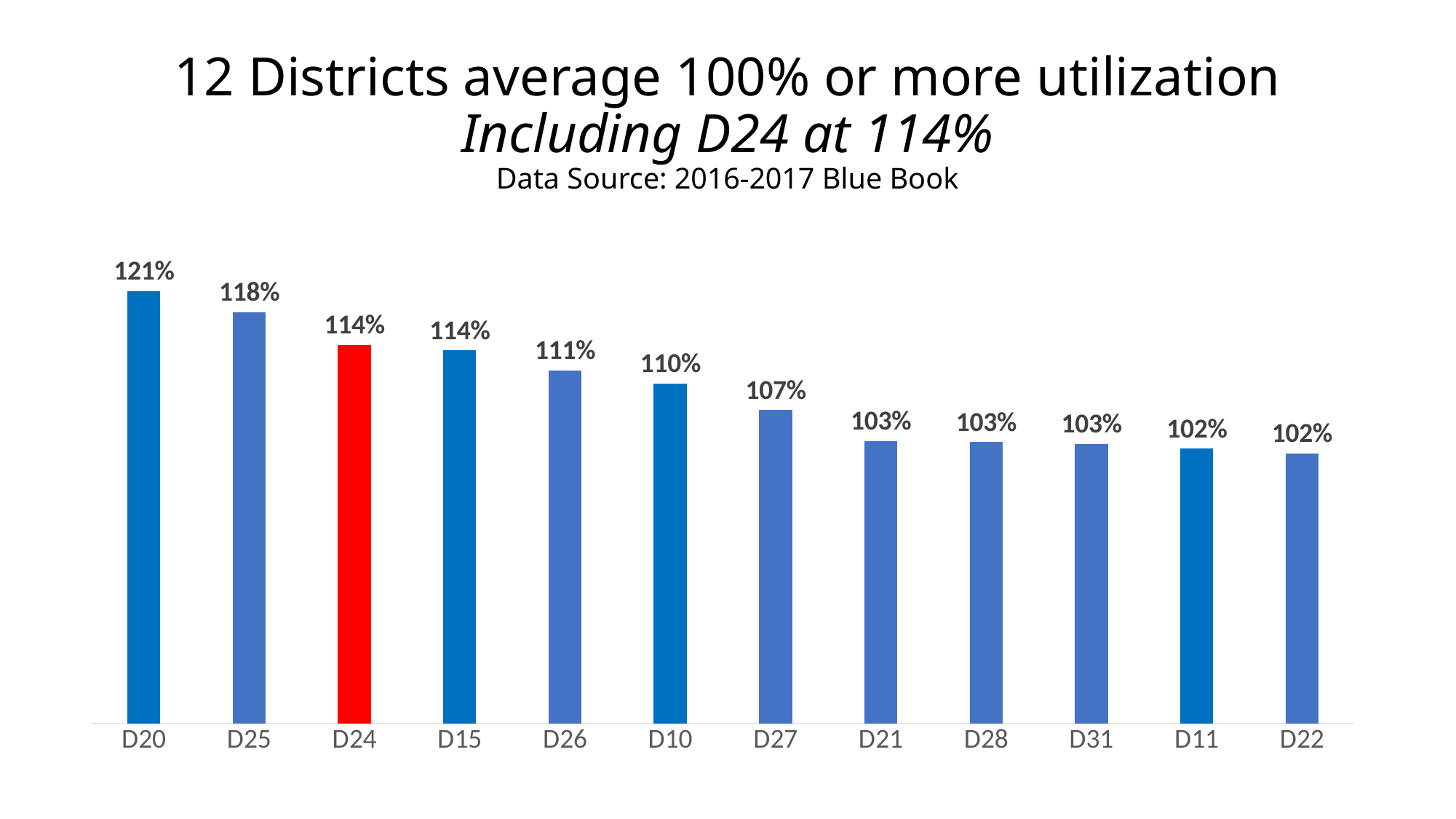
Do the values rise or fall from left to right along the x axis? Fall What is the utilization value for D20? 121% What is the difference between the utilization of D24 and D22? 12% What is the difference between the utilization of D20 and D25? 3% What kind of chart is shown on the slide? Bar chart What is the utilization value for D27? 107% What is the utilization value for D24? 114% What is the utilization value for D10? 110% Which district has the highest utilization? D20 Which has a higher utilization, D26 or D27? D26 Which district's bar is coloured red? D24 How many districts are shown in the chart? 12